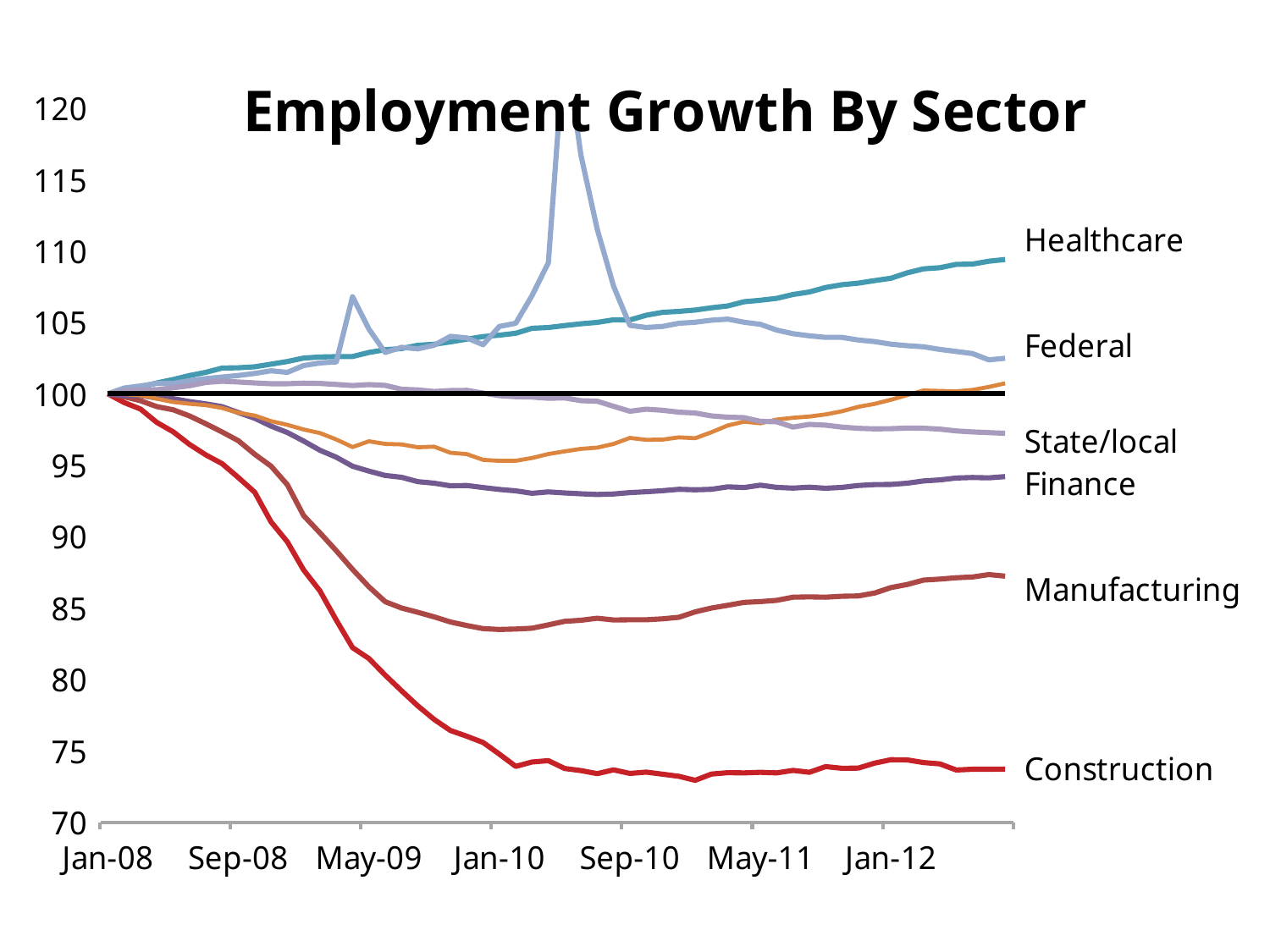
Which sector has the highest value at the right end of the chart? Healthcare What is the title of the chart? Employment Growth By Sector Does the Healthcare line rise or fall from Jan-08 to the end of the chart? Rise Is the value for Construction at the right end of the chart greater or less than 75? less What kind of chart is shown on the slide? Line chart Does the Construction line rise or fall from Jan-08 to Jan-10? Fall Which sector has the lowest value at the right end of the chart? Construction Is the value for Finance at the right end of the chart greater or less than 95? less Is the value for Manufacturing at the right end of the chart greater or less than 85? greater At the right end of the chart, which is higher: Healthcare or Federal? Healthcare